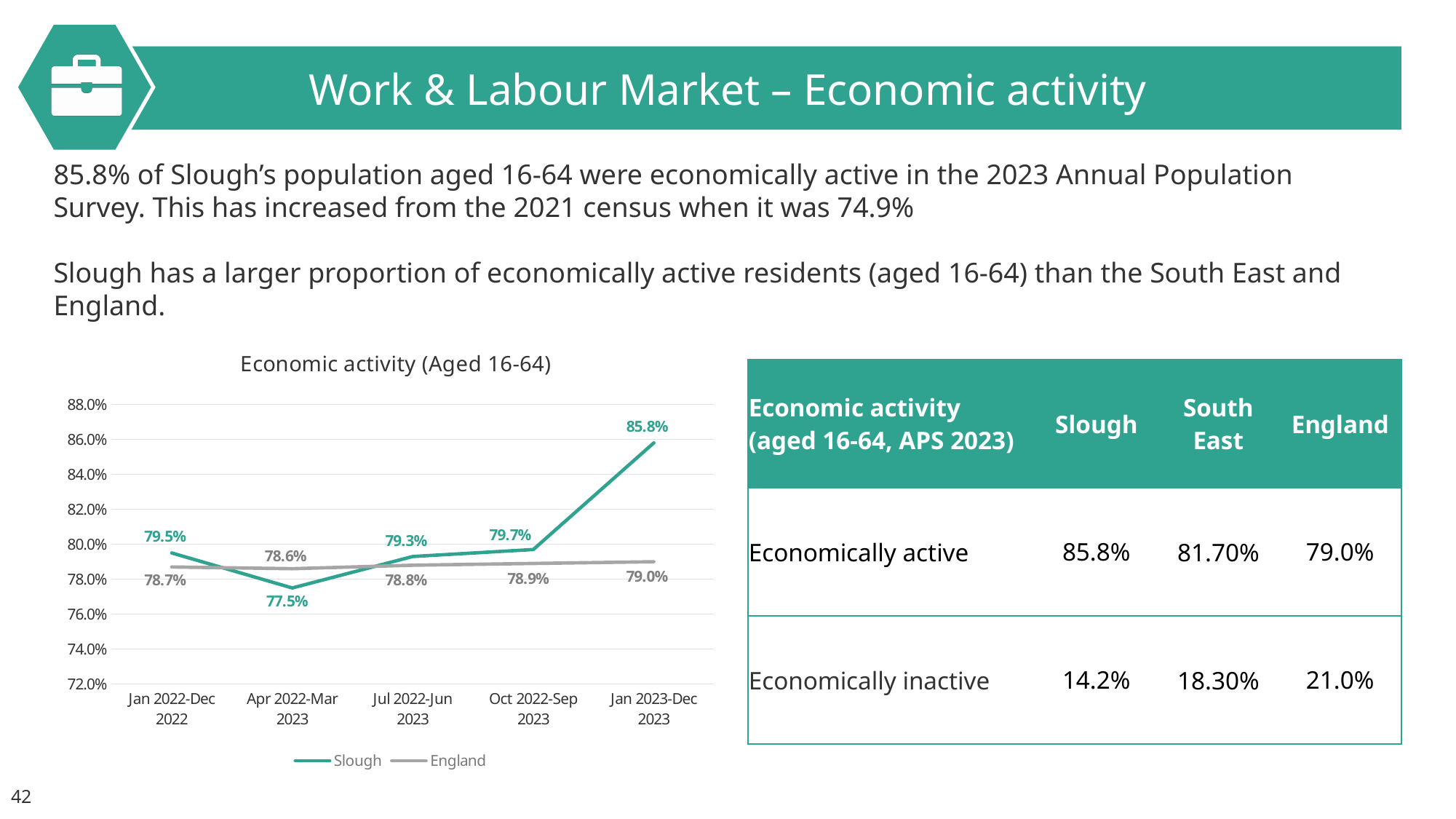
What type of chart is shown on the slide? Line chart In which period is the Slough value lowest? Apr 2022-Mar 2023 What is the difference between the Slough and England values in Jan 2023-Dec 2023? 6.8% What is the value for Slough in Apr 2022-Mar 2023? 77.5% What is the value for England in Apr 2022-Mar 2023? 78.6% In which period is the Slough value highest? Jan 2023-Dec 2023 What is the value for Slough in Jan 2023-Dec 2023? 85.8% What is the title of the chart? Economic activity (Aged 16-64) Does the England series rise or fall from Jul 2022-Jun 2023 to Jan 2023-Dec 2023? Rise How many series does the legend list? 2 Which is larger in Apr 2022-Mar 2023, the Slough value or the England value? England How many periods are shown on the x axis? 5